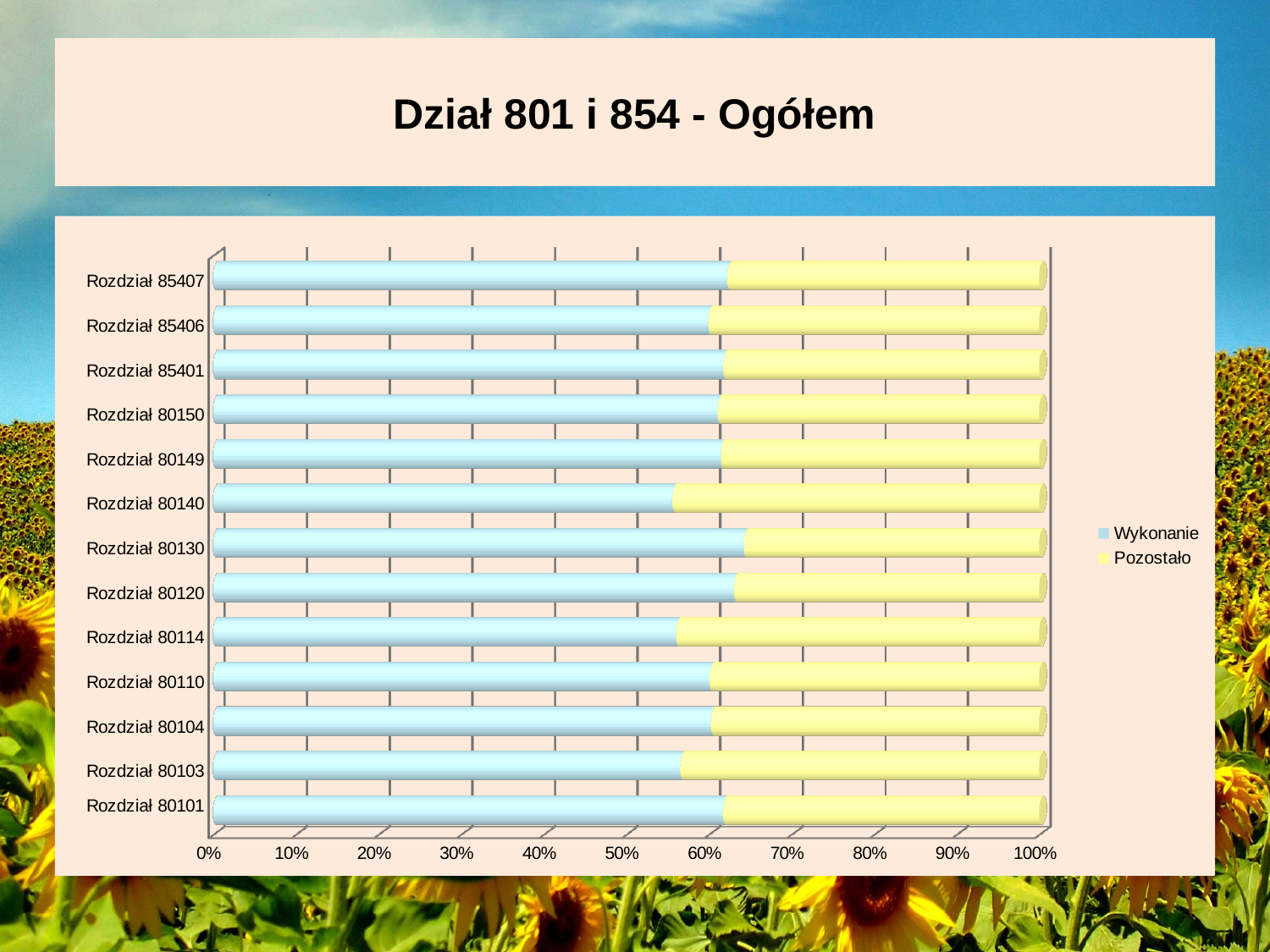
Is the Wykonanie value for Rozdział 85407 greater or less than 50%? greater Is the Wykonanie value for Rozdział 80114 greater or less than 60%? less What is the title of the chart? Dział 801 i 854 - Ogółem What are the two series named in the legend? Wykonanie and Pozostało How many categories (Rozdział entries) are plotted on the chart? 13 What kind of chart is shown on the slide? bar chart Is the Wykonanie value for Rozdział 80140 greater or less than 60%? less Which has the larger Wykonanie share, Rozdział 80101 or Rozdział 80103? Rozdział 80101 Which has the larger Wykonanie share, Rozdział 80130 or Rozdział 80140? Rozdział 80130 How many series does the legend list? 2